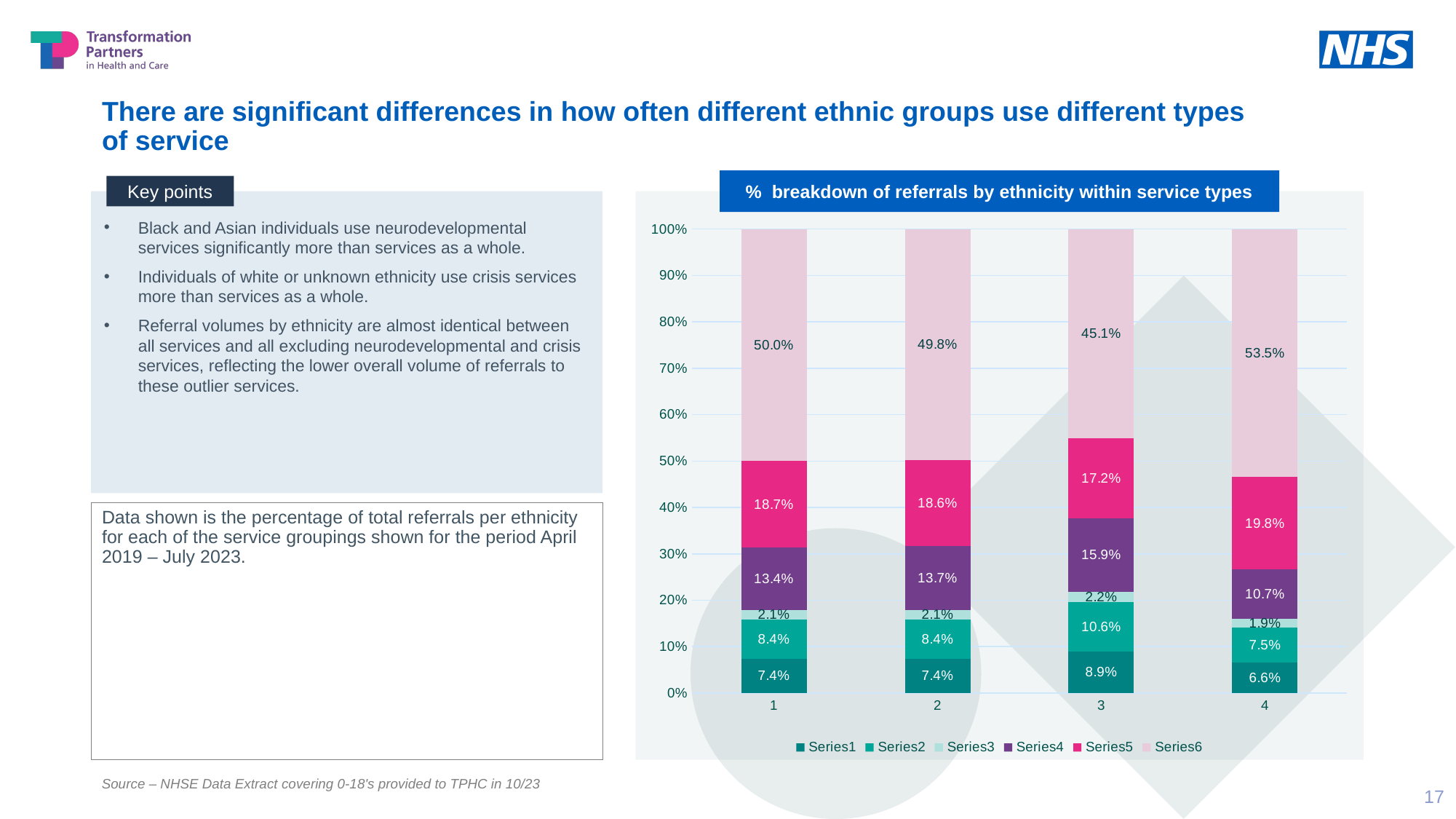
Which category has the highest value for Series6? 4 What is the title of the chart? % breakdown of referrals by ethnicity within service types Which is larger, the Series2 value for category 3 or for category 4? category 3 How many categories are shown on the x axis? 4 Is the Series6 value for category 3 greater or less than 50%? less Which category has the lowest value for Series4? 4 What is the difference between the Series5 values for category 4 and category 3? 2.6% How many series does the legend list? 6 What is the value of Series1 for category 3? 8.9% What type of chart is shown on the slide? stacked bar chart What is the value of Series4 for category 2? 13.7% What is the value of Series6 for category 4? 53.5%